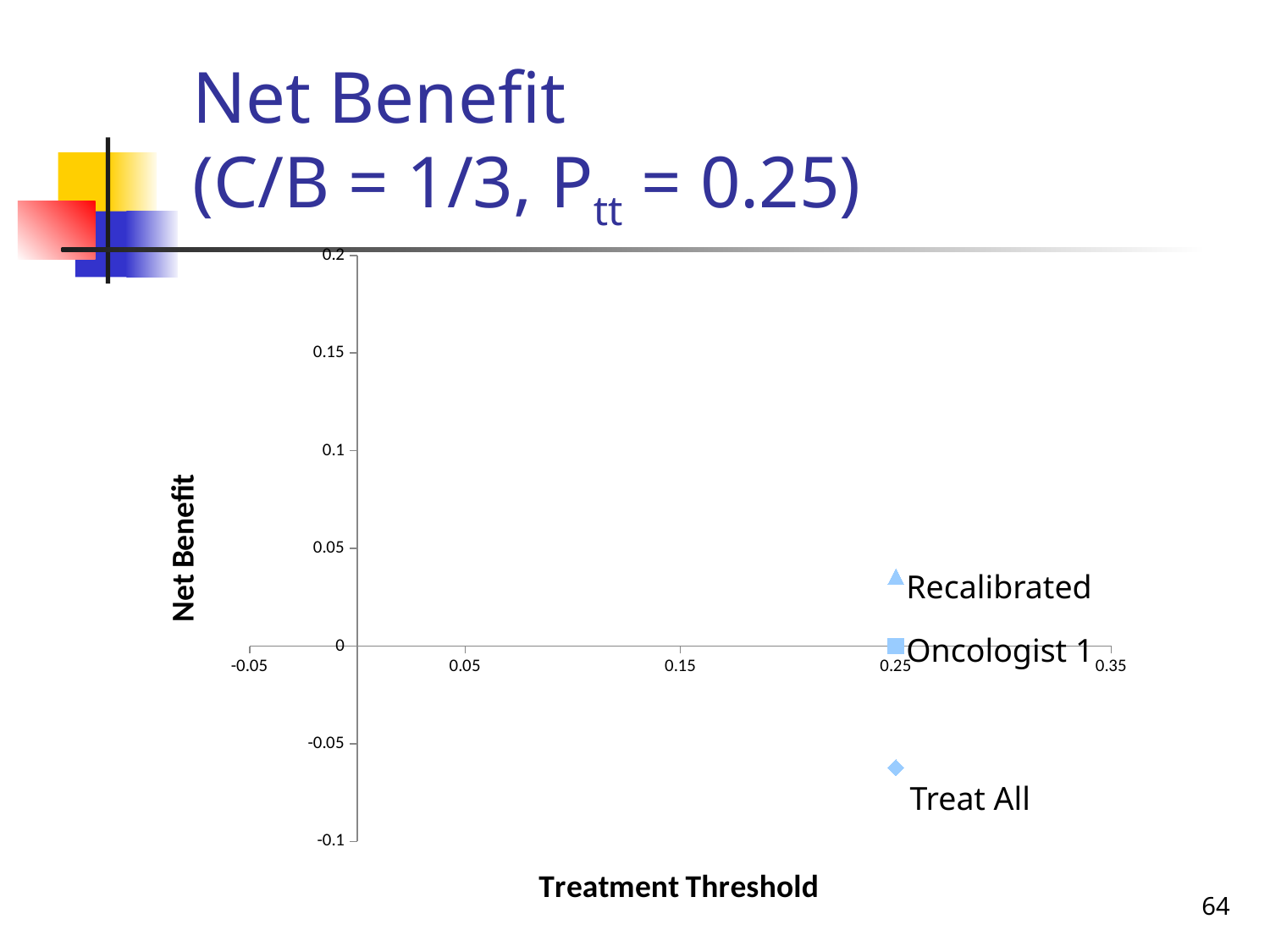
Is the net benefit for Recalibrated greater or less than 0? greater Which point has the highest net benefit? Recalibrated Which point has the lowest net benefit? Treat All What is the title of the x axis? Treatment Threshold At which treatment threshold value on the x axis are the points plotted? 0.25 What kind of chart is shown on the slide? scatter chart Which has a larger net benefit, Recalibrated or Treat All? Recalibrated Which has a larger net benefit, Oncologist 1 or Treat All? Oncologist 1 Is the net benefit for Treat All greater or less than -0.05? less Is the net benefit for Recalibrated greater or less than 0.05? less How many data points are plotted on the chart? 3 What is the title of the y axis? Net Benefit